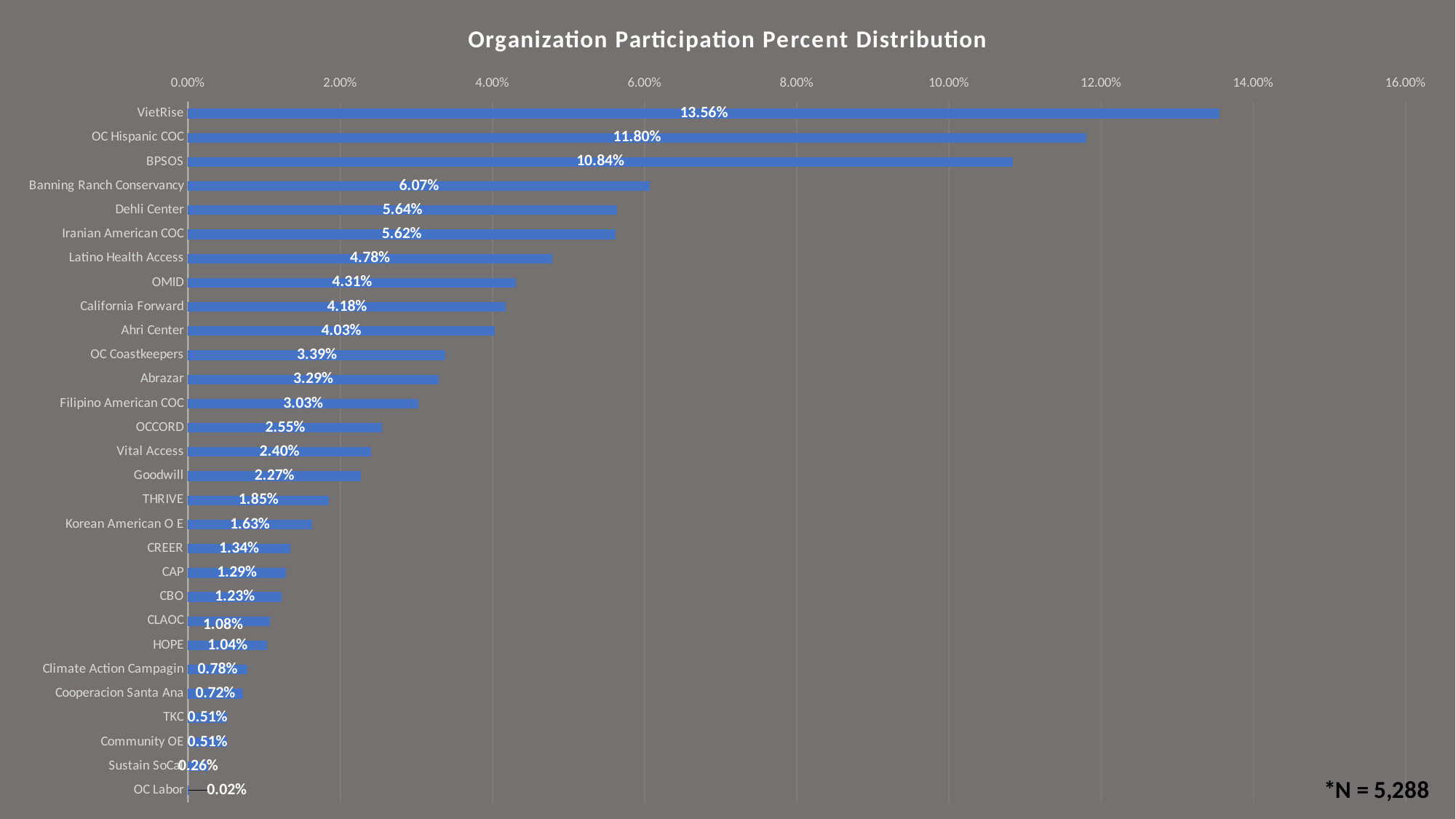
Which has a higher participation percentage, OMID or Ahri Center? OMID What is the difference in participation percentage between VietRise and OC Hispanic COC? 1.76% Is the value for Dehli Center greater or less than 4.00%? greater What is the participation percentage for Latino Health Access? 4.78% What is the title of the chart? Organization Participation Percent Distribution Which organization has the highest participation percentage? VietRise How many organizations are shown in the chart? 29 What is the difference in participation percentage between BPSOS and Banning Ranch Conservancy? 4.77% What is the participation percentage for Goodwill? 2.27% What kind of chart is shown on the slide? Bar chart Which organization has the lowest participation percentage? OC Labor What is the participation percentage for VietRise? 13.56%